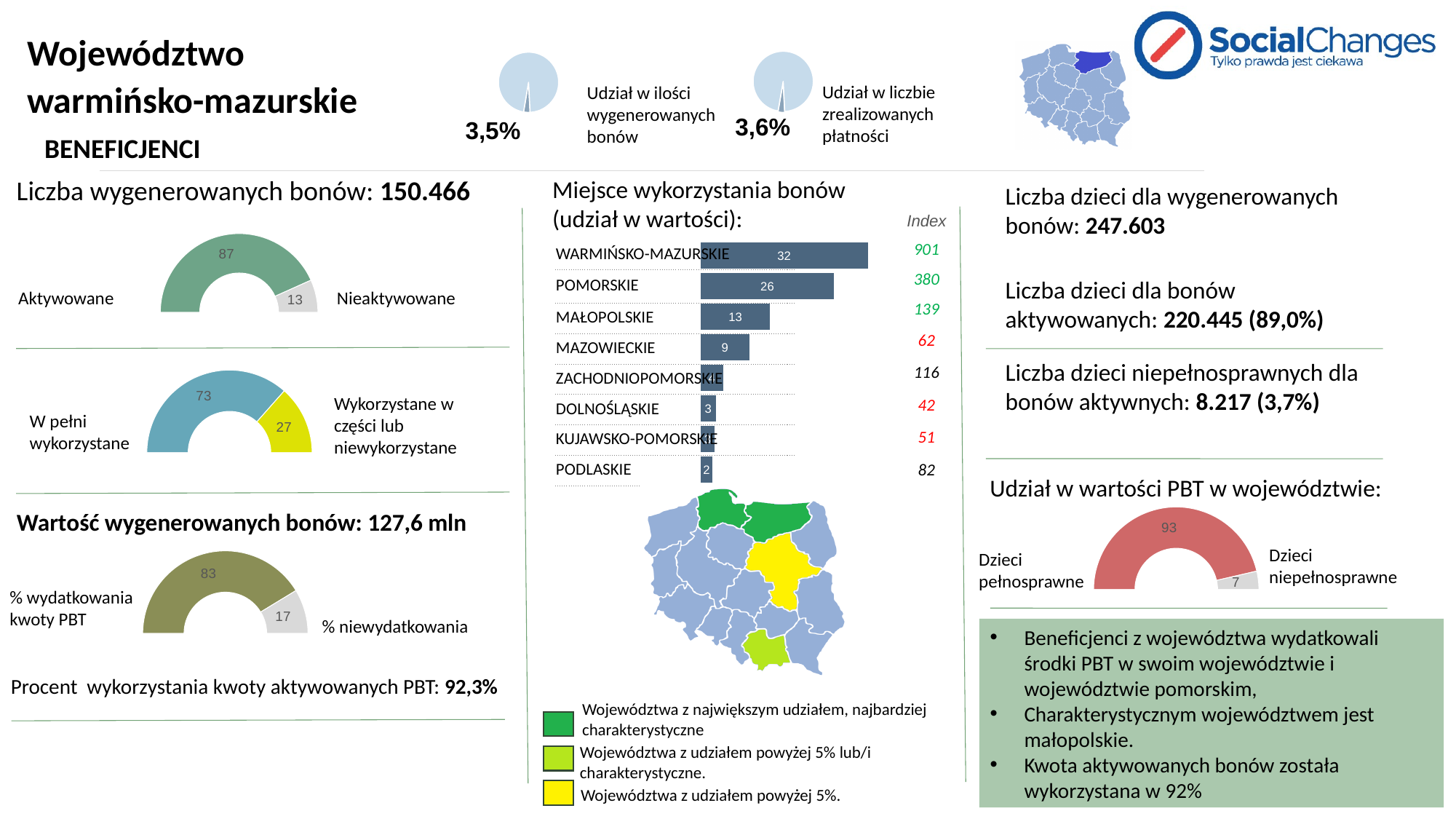
In the half-donut chart under 'Liczba wygenerowanych bonów', what is the value for Aktywowane? 87 In the 'Udział w wartości PBT w województwie' half-donut chart, what is the value for 'Dzieci pełnosprawne'? 93 In the half-donut chart with 'W pełni wykorzystane', what is the value for 'Wykorzystane w części lub niewykorzystane'? 27 In the half-donut chart under 'Wartość wygenerowanych bonów', what is the value for '% niewydatkowania'? 17 In the 'Miejsce wykorzystania bonów (udział w wartości)' bar chart, what is the difference between the values for WARMIŃSKO-MAZURSKIE and MAŁOPOLSKIE? 19 In the 'Miejsce wykorzystania bonów (udział w wartości)' bar chart, which is larger: the value for MAZOWIECKIE or DOLNOŚLĄSKIE? MAZOWIECKIE What kind of chart is 'Miejsce wykorzystania bonów (udział w wartości)'? bar chart In the 'Miejsce wykorzystania bonów (udział w wartości)' bar chart, which region has the highest value? WARMIŃSKO-MAZURSKIE In the small pie chart at the top labelled 'Udział w liczbie zrealizowanych płatności', what share is shown? 3,6% How many regions are listed in the 'Miejsce wykorzystania bonów (udział w wartości)' bar chart? 8 In the 'Miejsce wykorzystania bonów' chart, what is the Index value shown for PODLASKIE? 82 In the 'Miejsce wykorzystania bonów (udział w wartości)' bar chart, what is the value for POMORSKIE? 26